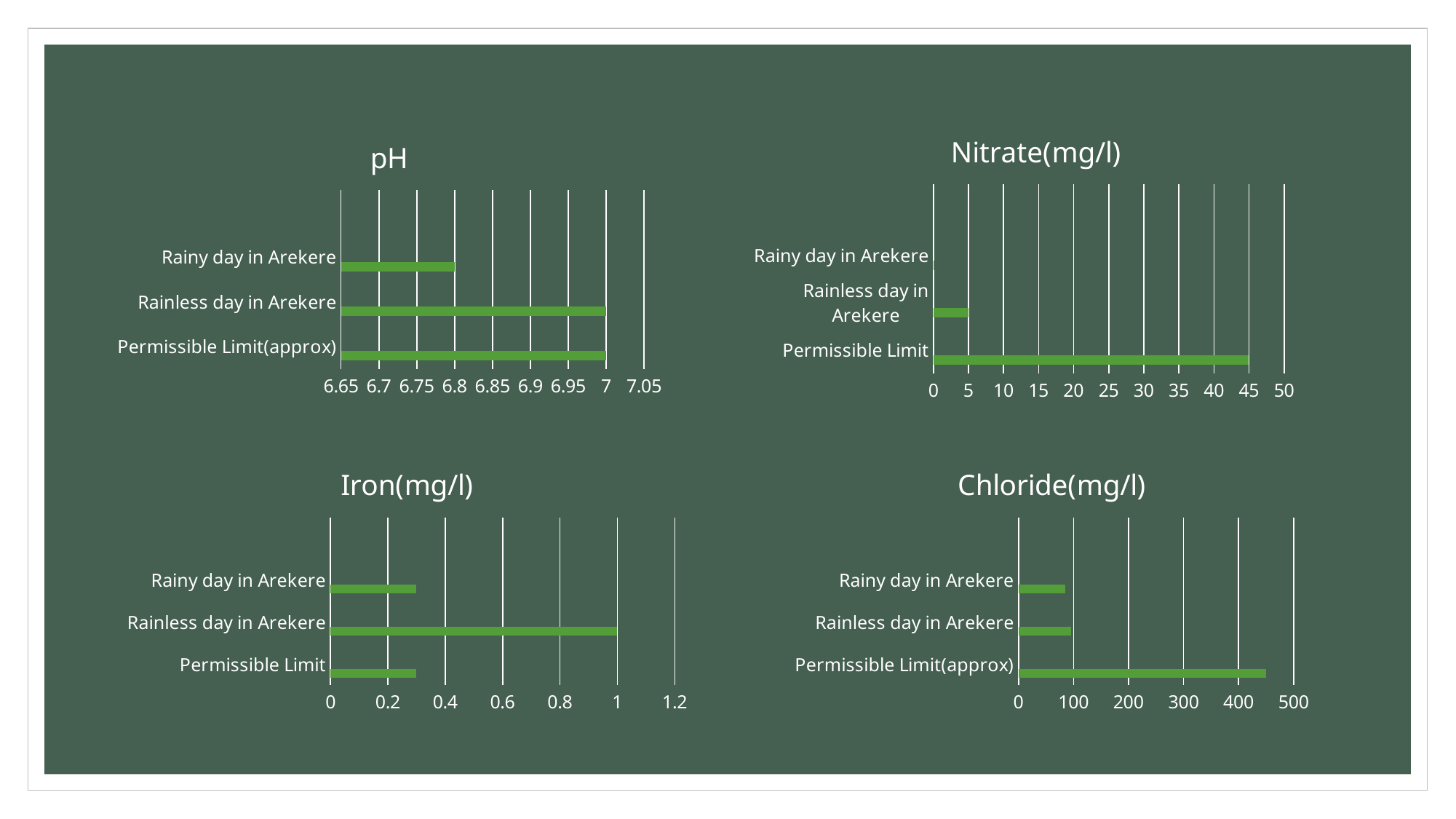
In the pH chart, what is the value for Rainy day in Arekere? 6.8 In the Iron(mg/l) chart, what is the value for Rainless day in Arekere? 1 In the Nitrate(mg/l) chart, what is the difference between the Permissible Limit and the Rainless day in Arekere value? 40 In the Nitrate(mg/l) chart, what is the value for Rainless day in Arekere? 5 In the Chloride(mg/l) chart, is the value for Permissible Limit(approx) greater or less than 400? greater In the pH chart, what is the value for Rainless day in Arekere? 7 What kind of chart is the Iron(mg/l) chart? bar chart In the Iron(mg/l) chart, which category has the highest value? Rainless day in Arekere How many categories does the Chloride(mg/l) chart show? 3 In the Chloride(mg/l) chart, is the value for Rainy day in Arekere greater or less than 100? less In the Nitrate(mg/l) chart, what is the value for Permissible Limit? 45 In the pH chart, which category has the lowest value? Rainy day in Arekere